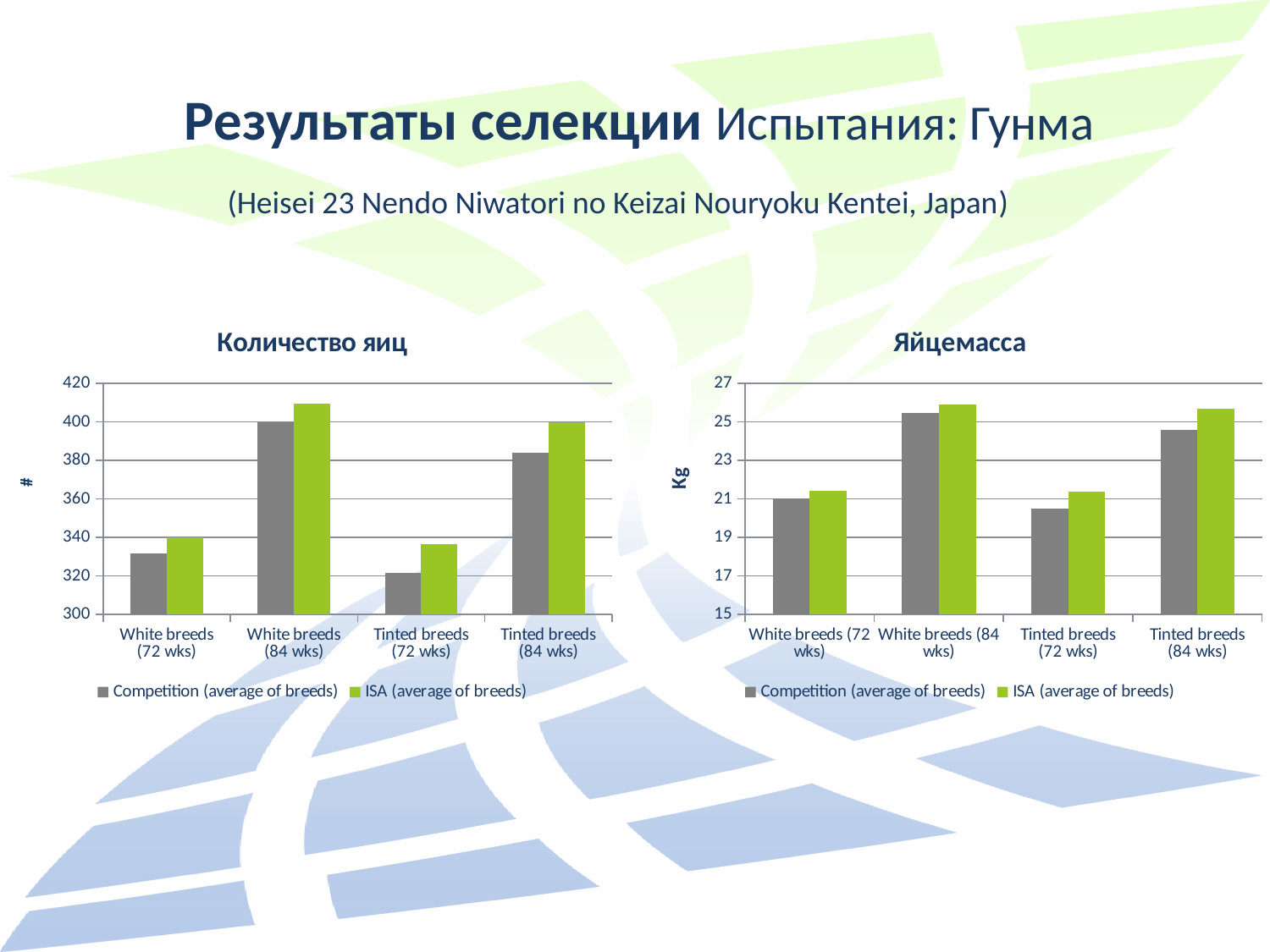
What kind of chart is the "Количество яиц" chart? Bar chart What is the y-axis label of the "Яйцемасса" chart? Kg In the "Яйцемасса" chart, is the Competition value for White breeds (84 wks) greater or less than 25? greater How many categories are shown on the x axis of the "Яйцемасса" chart? 4 How many series does the legend of the "Количество яиц" chart list? 2 In the "Яйцемасса" chart, which bar is the highest? ISA (average of breeds), White breeds (84 wks) In the "Количество яиц" chart, is the Competition value for White breeds (72 wks) greater or less than 340? less In the "Количество яиц" chart, is the Competition value for Tinted breeds (84 wks) greater or less than 380? greater In the "Количество яиц" chart, which bar is the highest? ISA (average of breeds), White breeds (84 wks) In the "Количество яиц" chart, for White breeds (84 wks), which series has the larger value: Competition or ISA? ISA (average of breeds) In the "Количество яиц" chart, which bar is the lowest? Competition (average of breeds), Tinted breeds (72 wks)